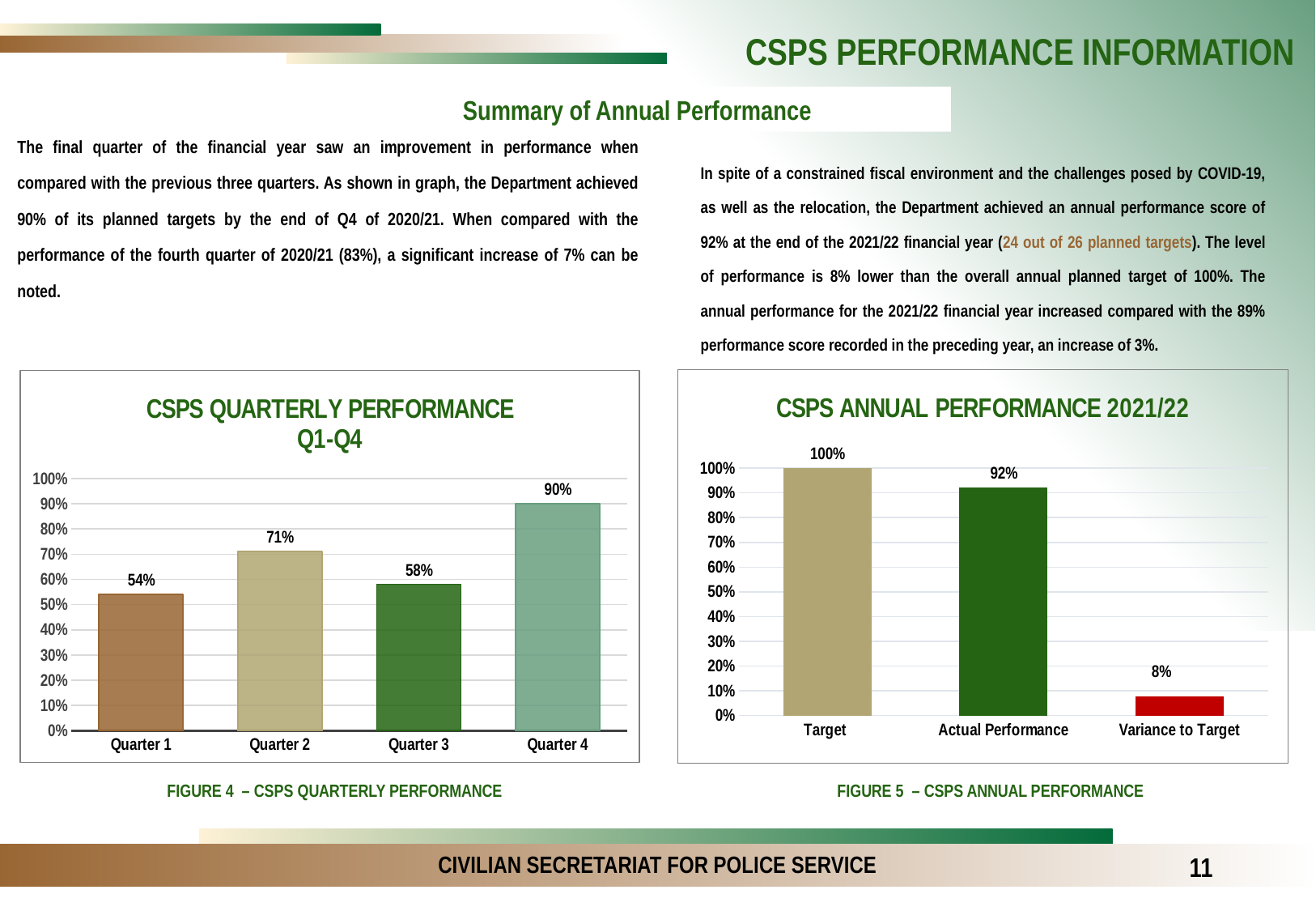
In the CSPS Quarterly Performance Q1-Q4 chart, what is the difference between Quarter 4 and Quarter 3? 32% In the CSPS Quarterly Performance Q1-Q4 chart, which quarter has the lowest value? Quarter 1 In the CSPS Quarterly Performance Q1-Q4 chart, which quarter has the highest value? Quarter 4 What type of chart is the CSPS Annual Performance 2021/22 chart? Bar chart In the CSPS Quarterly Performance Q1-Q4 chart, which is larger, Quarter 2 or Quarter 3? Quarter 2 In the CSPS Annual Performance 2021/22 chart, what colour is the Variance to Target bar? Red In the CSPS Annual Performance 2021/22 chart, what is the difference between Target and Actual Performance? 8% In the CSPS Annual Performance 2021/22 chart, what is the value for Variance to Target? 8% In the CSPS Annual Performance 2021/22 chart, what is the value for Actual Performance? 92% In the CSPS Quarterly Performance Q1-Q4 chart, what is the value for Quarter 1? 54% How many quarters are shown in the CSPS Quarterly Performance Q1-Q4 chart? 4 In the CSPS Quarterly Performance Q1-Q4 chart, what is the value for Quarter 3? 58%